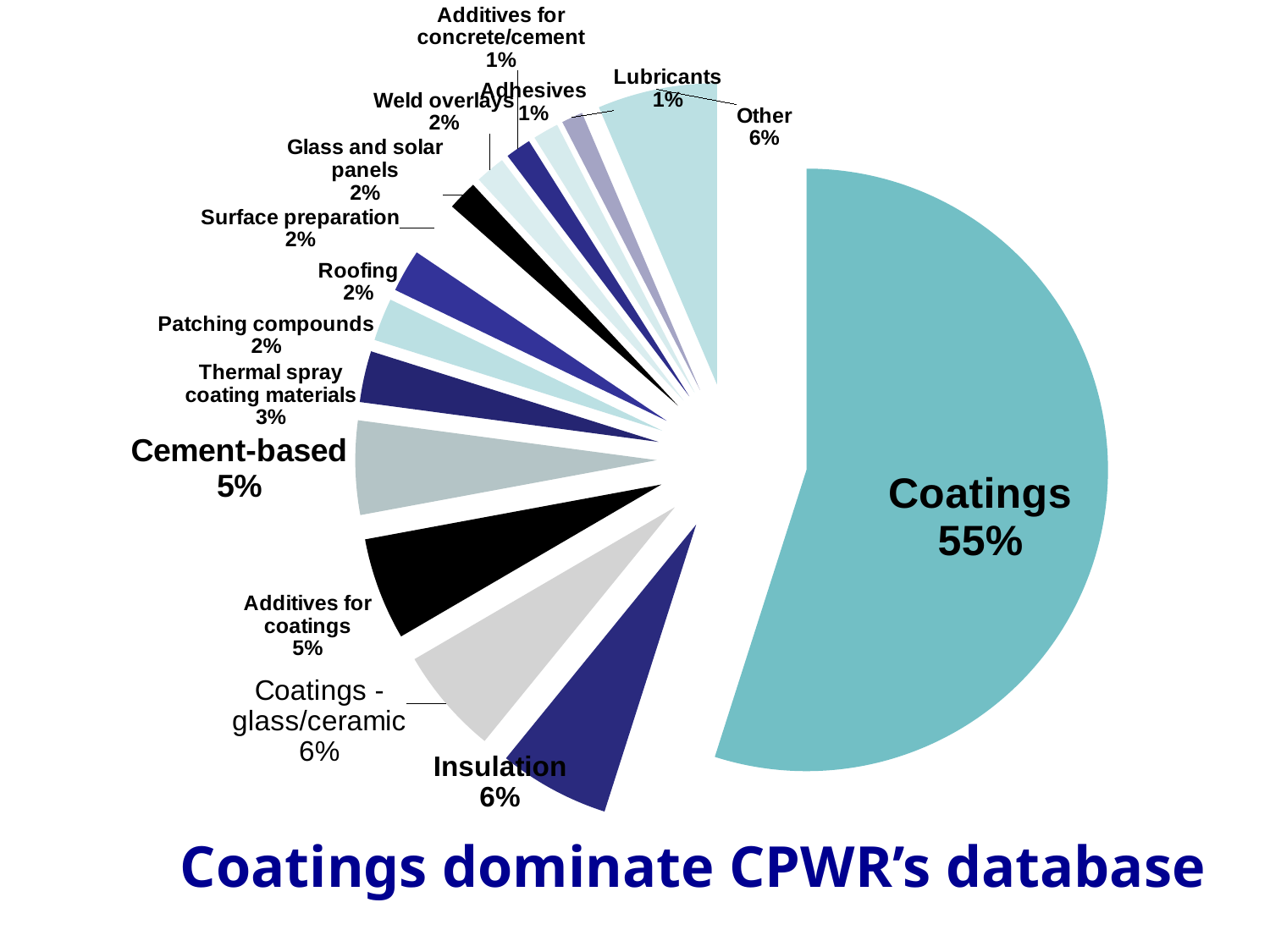
What share of the pie does Lubricants have? 1% What share of the pie does Cement-based have? 5% What share of the pie does Thermal spray coating materials have? 3% How many slices does the pie chart have? 15 What is the caption text below the chart? Coatings dominate CPWR's database What share of the pie does Insulation have? 6% Which is larger, the share for Additives for coatings or the share for Roofing? Additives for coatings Which category has the largest share of the pie? Coatings What kind of chart is shown on the slide? pie chart What share of the pie does Other have? 6% What share of the pie does Coatings have? 55% What is the difference in percentage points between Coatings and Insulation? 49